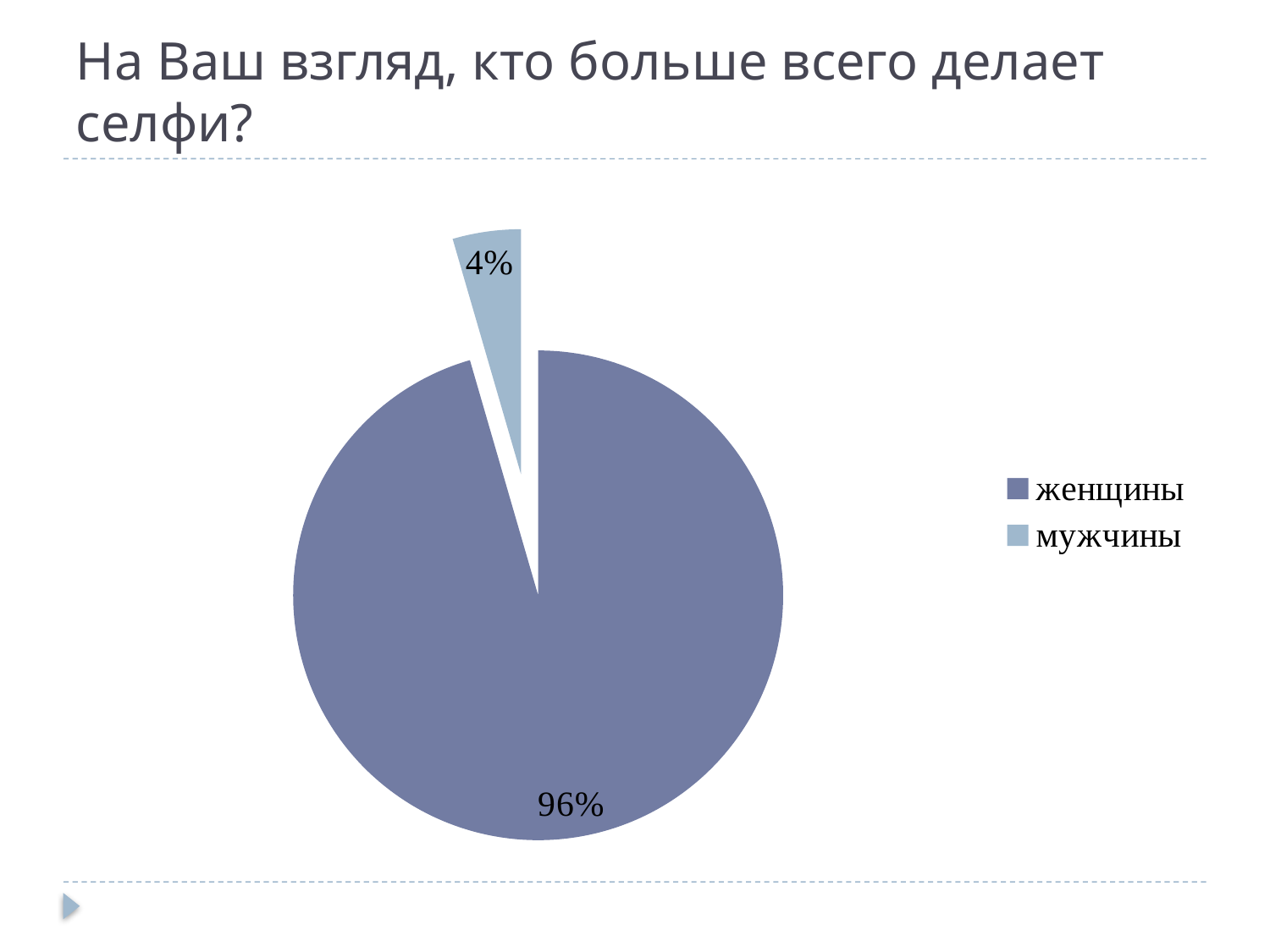
What is the difference between the shares for женщины and мужчины? 92% Which category has the largest slice of the pie? женщины Which category is shown in the lighter blue colour? мужчины How many entries does the legend list? 2 What kind of chart is shown on the slide? pie chart What share of the pie does женщины have? 96% What share of the pie does мужчины have? 4% How many categories does the pie chart have? 2 What is the title of the slide above the chart? На Ваш взгляд, кто больше всего делает селфи? Which category has the smallest slice of the pie? мужчины Which is larger, the share for женщины or the share for мужчины? женщины